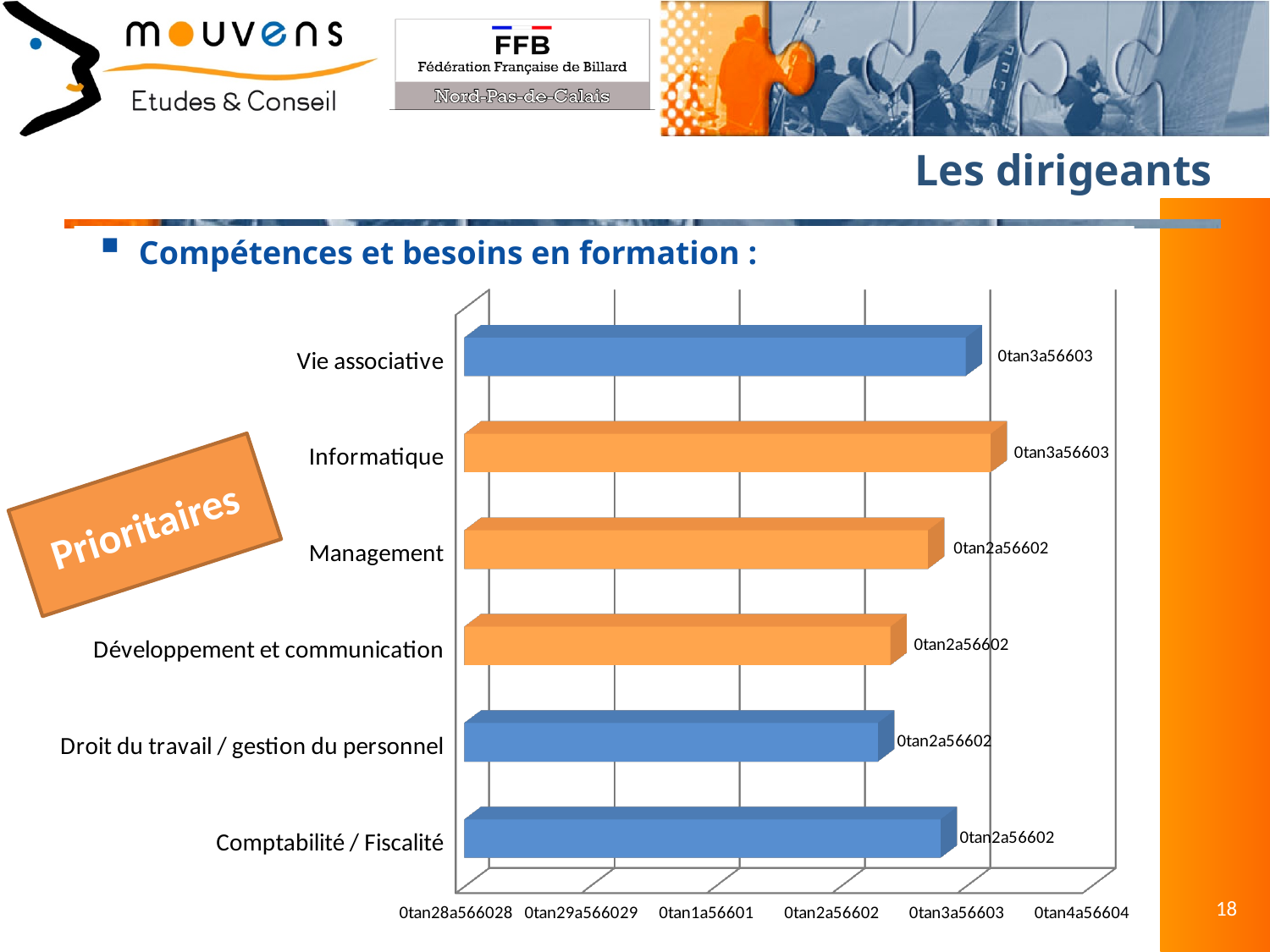
What is the heading above the chart? Compétences et besoins en formation : What data label is printed next to the Management bar? 0tan2a56602 What data label is printed next to the Informatique bar? 0tan3a56603 How many categories are plotted in the chart? 6 Which bar is longer, Informatique or Management? Informatique Which bar is longer, Vie associative or Comptabilité / Fiscalité? Vie associative Which category is listed at the top of the chart? Vie associative What type of chart is shown on the slide? bar chart What data label is printed next to the Comptabilité / Fiscalité bar? 0tan2a56602 Which category is listed at the bottom of the chart? Comptabilité / Fiscalité